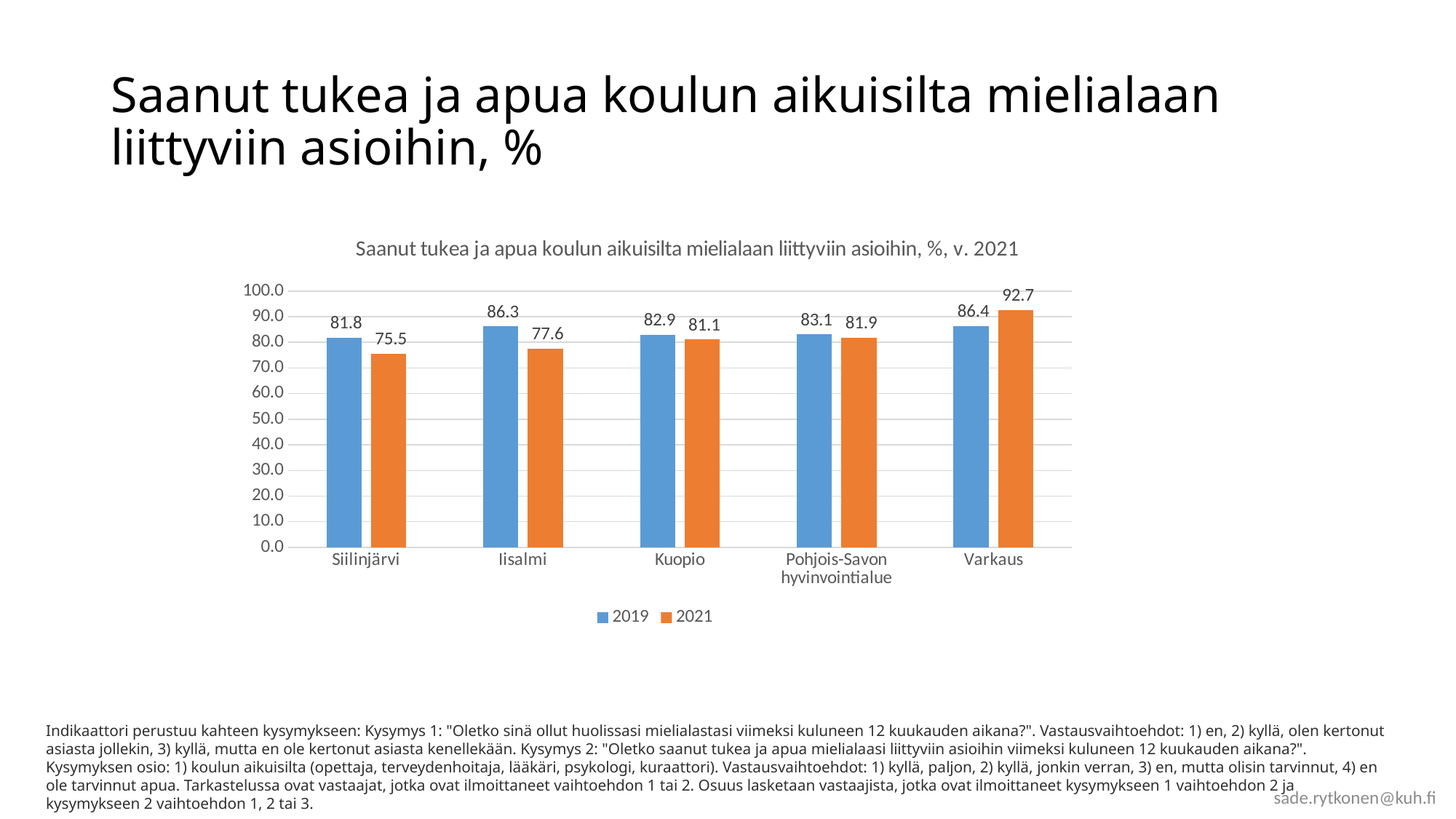
Which is larger for Kuopio, the 2019 value or the 2021 value? 2019 What kind of chart is shown on the slide? Bar chart What is the 2019 value for Siilinjärvi? 81.8 Which category has the lowest 2021 value? Siilinjärvi How many series does the legend list? 2 Which category has the highest 2021 value? Varkaus What is the 2021 value for Pohjois-Savon hyvinvointialue? 81.9 Which series is shown in orange? 2021 What is the 2021 value for Varkaus? 92.7 What is the difference between the 2019 and 2021 values for Iisalmi? 8.7 How many categories are shown on the x axis? 5 Which category has the lowest 2019 value? Siilinjärvi